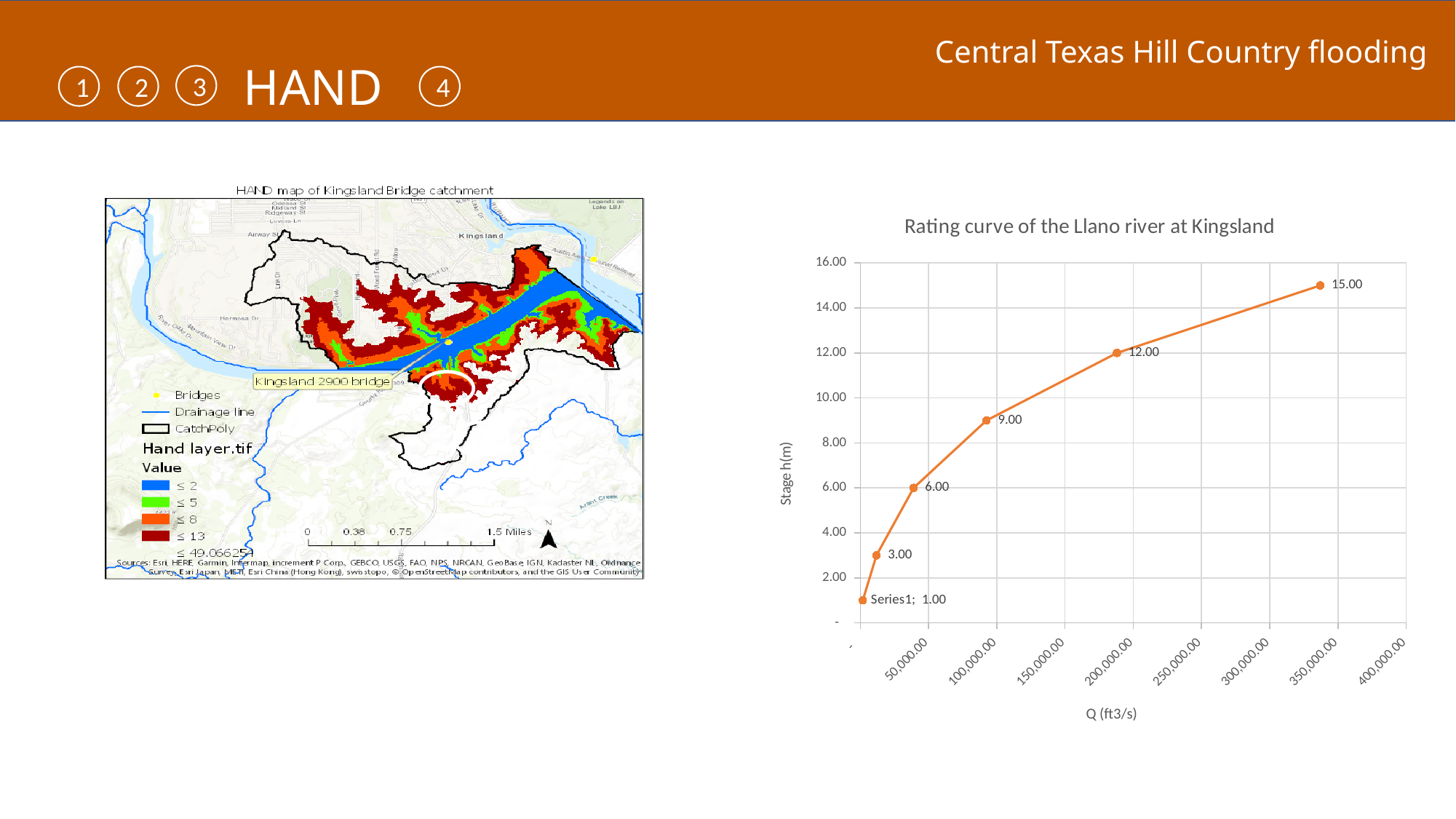
On the rating curve chart, which is larger: the stage at the second point (3.00) or the stage at the fourth point (9.00)? 9.00 What is the highest stage value labeled on the rating curve chart? 15.00 On the rating curve chart, is the Q value for the point with stage 12.00 greater or less than 150,000.00? greater What is the lowest stage value labeled on the rating curve chart? 1.00 What is the y-axis title of the rating curve chart? Stage h(m) How many data points are plotted on the rating curve chart? 6 What is the x-axis title of the rating curve chart? Q (ft3/s) On the rating curve chart, does the stage rise or fall as Q increases along the x axis? rise What kind of chart is the 'Rating curve of the Llano river at Kingsland'? line chart On the rating curve chart, is the Q value for the point with stage 15.00 greater or less than 300,000.00? greater On the rating curve chart, what is the difference between the highest and lowest labeled stage values? 14.00 On the rating curve chart, is the Q value for the point with stage 6.00 greater or less than 50,000.00? less